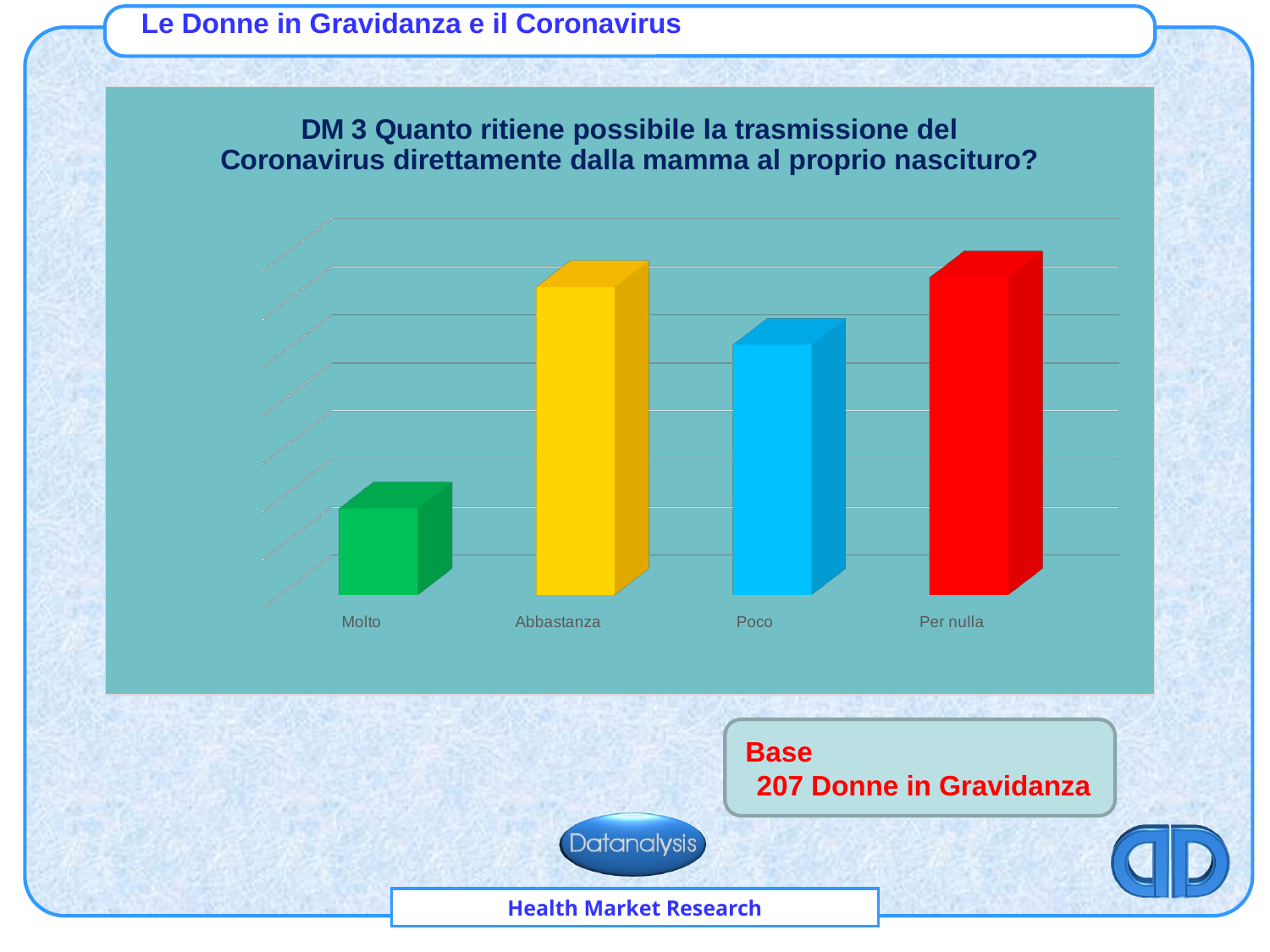
Which is larger, the value for Molto or the value for Poco? Poco What colour is the bar for Per nulla? Red Which category has the lowest value in the chart? Molto What kind of chart is shown on the slide? Bar chart What colour is the bar for Molto? Green Which is larger, the value for Abbastanza or the value for Poco? Abbastanza Which is larger, the value for Per nulla or the value for Poco? Per nulla How many categories are shown on the x axis of the chart? 4